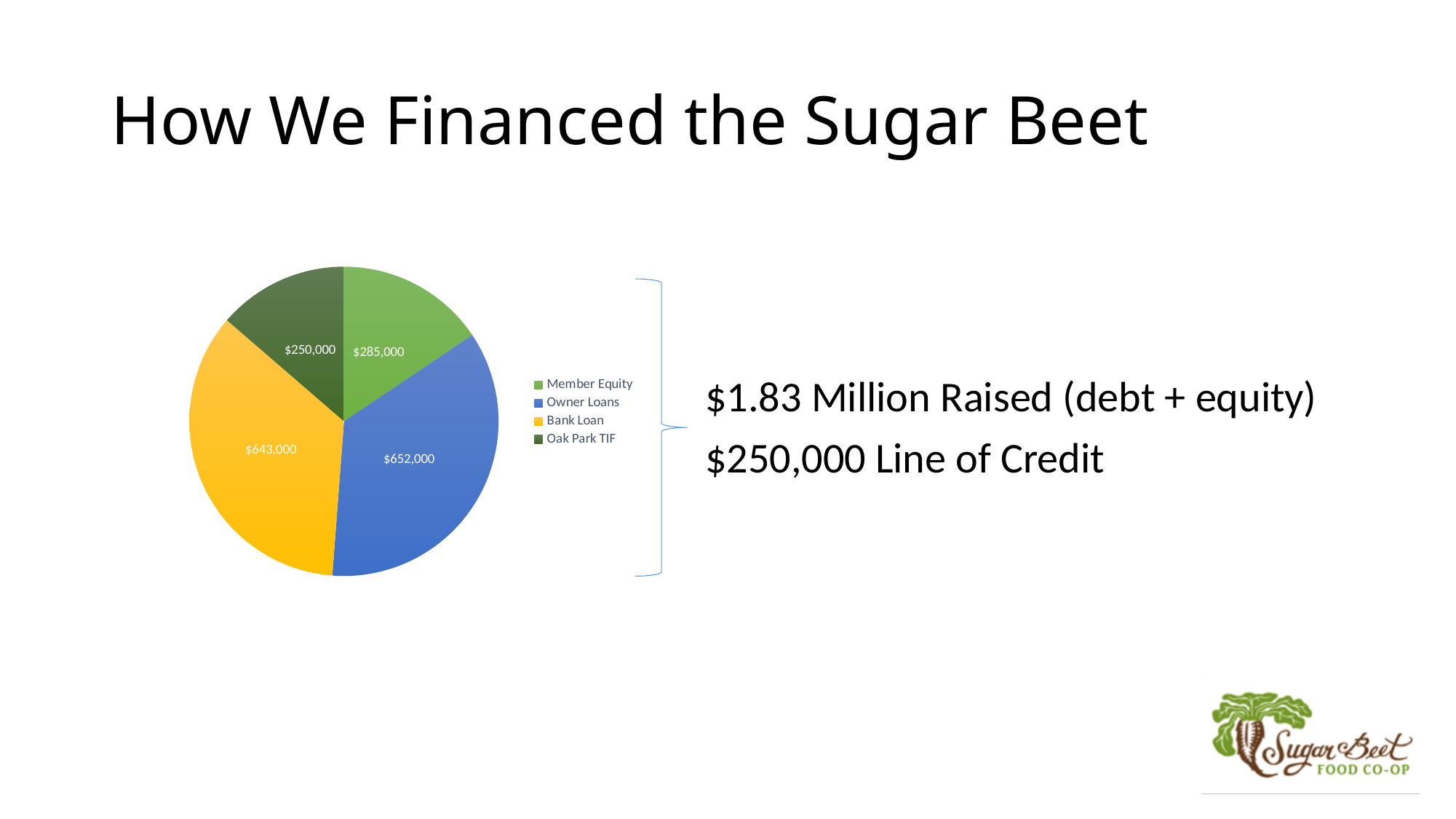
What is the difference between the Member Equity value and the Oak Park TIF value? $35,000 What colour is the Bank Loan slice in the pie chart? Yellow What is the difference between the Owner Loans value and the Bank Loan value? $9,000 What type of chart is shown on the slide? Pie chart Which category has the smallest value in the pie chart? Oak Park TIF Which is larger, Bank Loan or Member Equity? Bank Loan What is the value for Bank Loan in the pie chart? $643,000 How many categories does the pie chart have? 4 What is the value for Oak Park TIF in the pie chart? $250,000 Which category has the largest value in the pie chart? Owner Loans What is the value for Member Equity in the pie chart? $285,000 What is the value for Owner Loans in the pie chart? $652,000